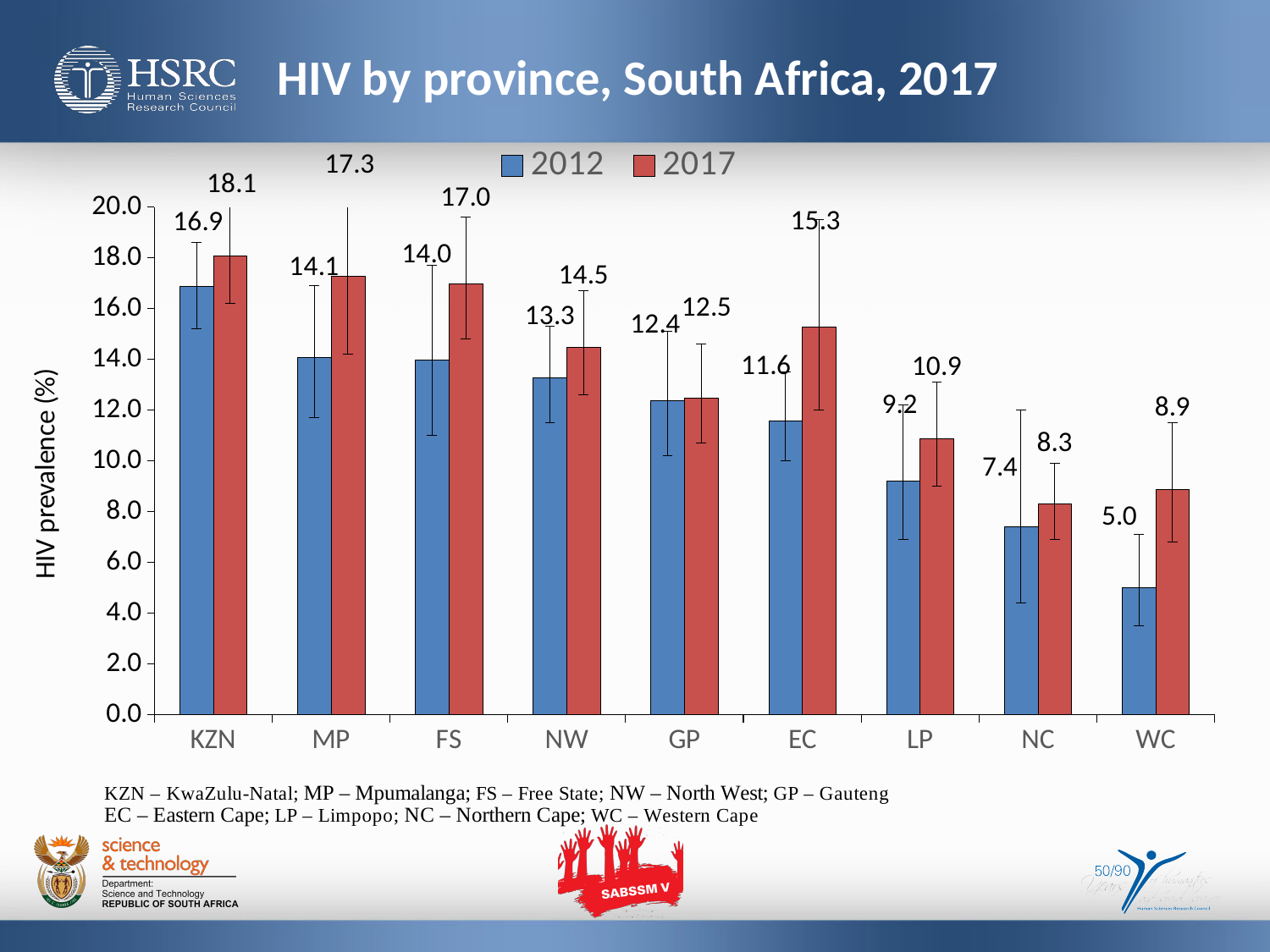
What kind of chart is shown on the slide? bar chart Is the 2012 value for NC greater or less than 8.0? less Which colour represents the 2017 series in the legend? red What is the HIV prevalence for WC in 2012? 5.0 What is the difference between the 2017 and 2012 HIV prevalence for EC? 3.7 What is the HIV prevalence for EC in 2017? 15.3 How many series does the legend list? 2 How many provinces are shown on the x axis? 9 Which is larger, the 2017 value for MP or the 2017 value for FS? MP Which province has the highest HIV prevalence in 2017? KZN Which province has the lowest HIV prevalence in 2012? WC What is the HIV prevalence for KZN in 2017? 18.1